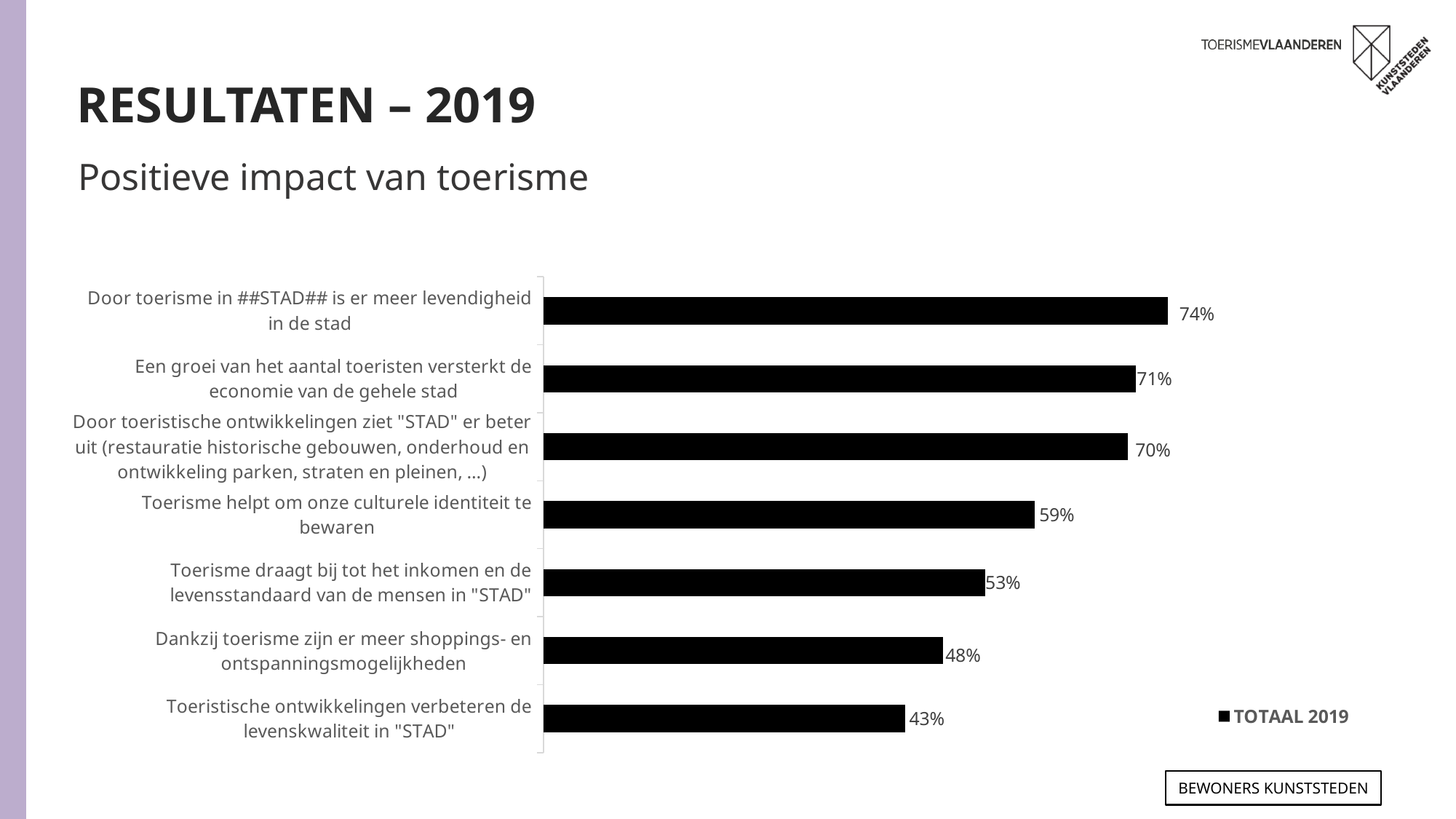
How many categories are shown in the chart? 7 What is the difference between the highest value (74%) and the lowest value (43%)? 31% Which is larger: the value for "Toerisme helpt om onze culturele identiteit te bewaren" or the value for "Toerisme draagt bij tot het inkomen en de levensstandaard van de mensen in "STAD""? Toerisme helpt om onze culturele identiteit te bewaren What is the difference between "Toerisme draagt bij tot het inkomen en de levensstandaard van de mensen in "STAD"" and "Dankzij toerisme zijn er meer shoppings- en ontspanningsmogelijkheden"? 5% What is the value for "Een groei van het aantal toeristen versterkt de economie van de gehele stad"? 71% Which category has the lowest value? Toeristische ontwikkelingen verbeteren de levenskwaliteit in "STAD" Which category has the highest value? Door toerisme in ##STAD## is er meer levendigheid in de stad What is the name of the series shown in the legend? TOTAAL 2019 What is the value for "Toerisme helpt om onze culturele identiteit te bewaren"? 59% What kind of chart is shown on the slide? Bar chart How many series does the legend list? 1 What is the value for "Dankzij toerisme zijn er meer shoppings- en ontspanningsmogelijkheden"? 48%